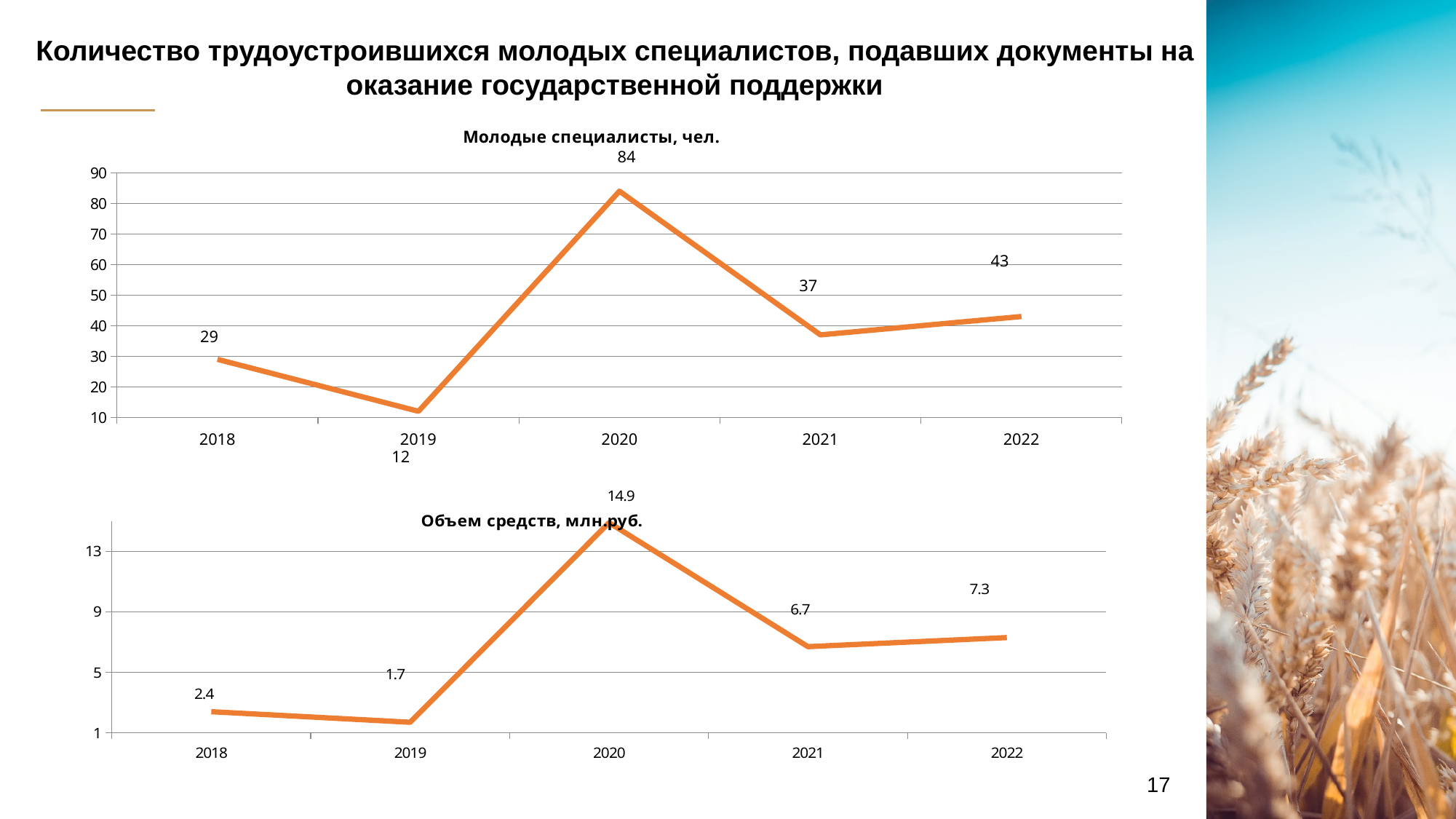
In the chart titled "Молодые специалисты, чел.", what is the difference between the values for 2020 and 2021? 47 In the chart titled "Объем средств, млн.руб.", what is the value for 2021? 6.7 In the chart titled "Молодые специалисты, чел.", which year has the lowest value? 2019 In the chart titled "Молодые специалисты, чел.", what is the value for 2020? 84 What type of chart is the chart titled "Объем средств, млн.руб."? line chart In the chart titled "Объем средств, млн.руб.", what is the value for 2019? 1.7 In the chart titled "Объем средств, млн.руб.", which year has the highest value? 2020 In the chart titled "Объем средств, млн.руб.", what is the difference between the values for 2022 and 2021? 0.6 In the chart titled "Объем средств, млн.руб.", is the value for 2022 larger or smaller than the value for 2018? larger In the chart titled "Молодые специалисты, чел.", how many years are plotted on the x axis? 5 In the chart titled "Молодые специалисты, чел.", what is the value for 2018? 29 In the chart titled "Молодые специалисты, чел.", which year has the highest value? 2020